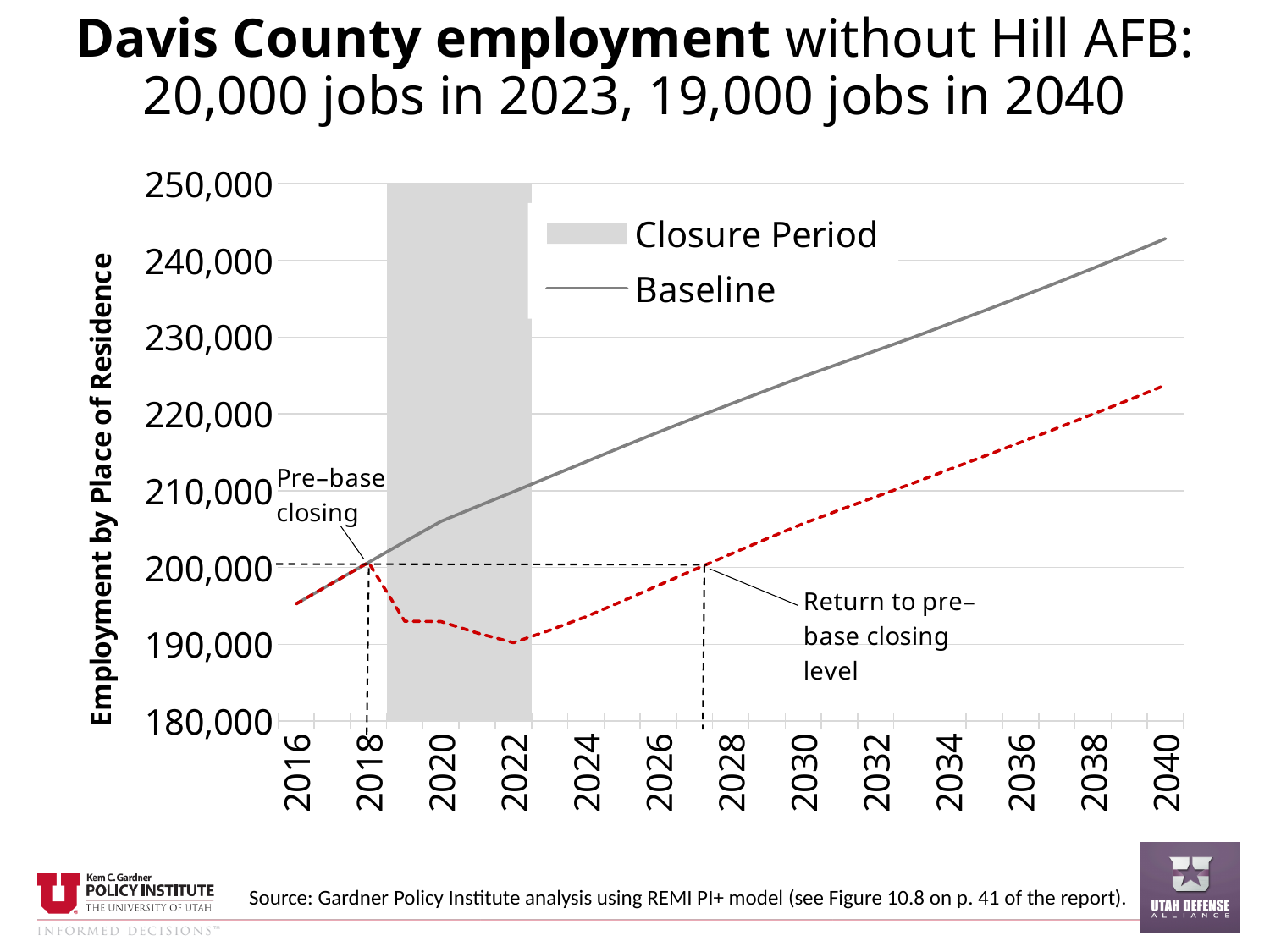
What are the two entries in the chart legend? Closure Period and Baseline In 2030, which is higher: the Baseline line or the red dashed line? Baseline Is the Baseline value in 2040 greater or less than 240,000? greater Does the Baseline line rise or fall from 2016 to 2040? rise Is the value of the red dashed line in 2022 greater or less than 200,000? less How many year labels are shown on the horizontal axis? 13 In which year does the chart mark the pre-base closing point? 2018 How many entries does the chart legend list? 2 What kind of chart is shown on the slide? line chart Is the value of the red dashed line in 2040 greater or less than 220,000? greater What employment level is marked as the pre-base closing level on the chart? 200,000 What is the label on the vertical axis of the chart? Employment by Place of Residence